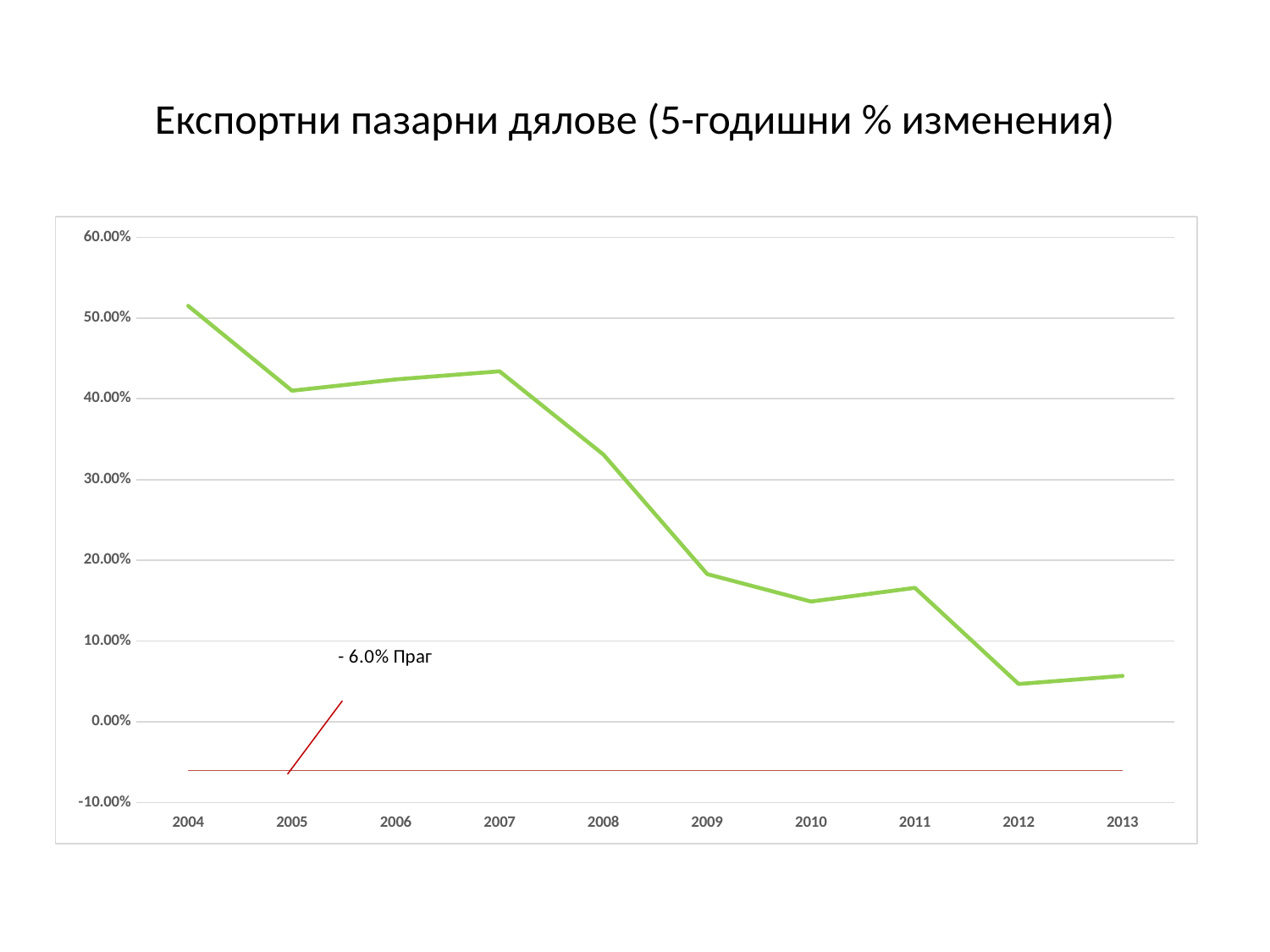
Which is larger, the value for 2007 or the value for 2008? 2007 Is the value for 2012 greater or less than 10.00%? less Is the value for 2008 greater or less than 30.00%? greater What is the title of the chart? Експортни пазарни дялове (5-годишни % изменения) Is the value for 2009 greater or less than 20.00%? less What kind of chart is shown on the slide? line chart What threshold value is marked by the red horizontal line on the chart? - 6.0% Праг How many years are plotted along the x axis? 10 Which is larger, the value for 2010 or the value for 2005? 2005 Do the values generally rise or fall from 2004 to 2013? fall Which year has the highest value? 2004